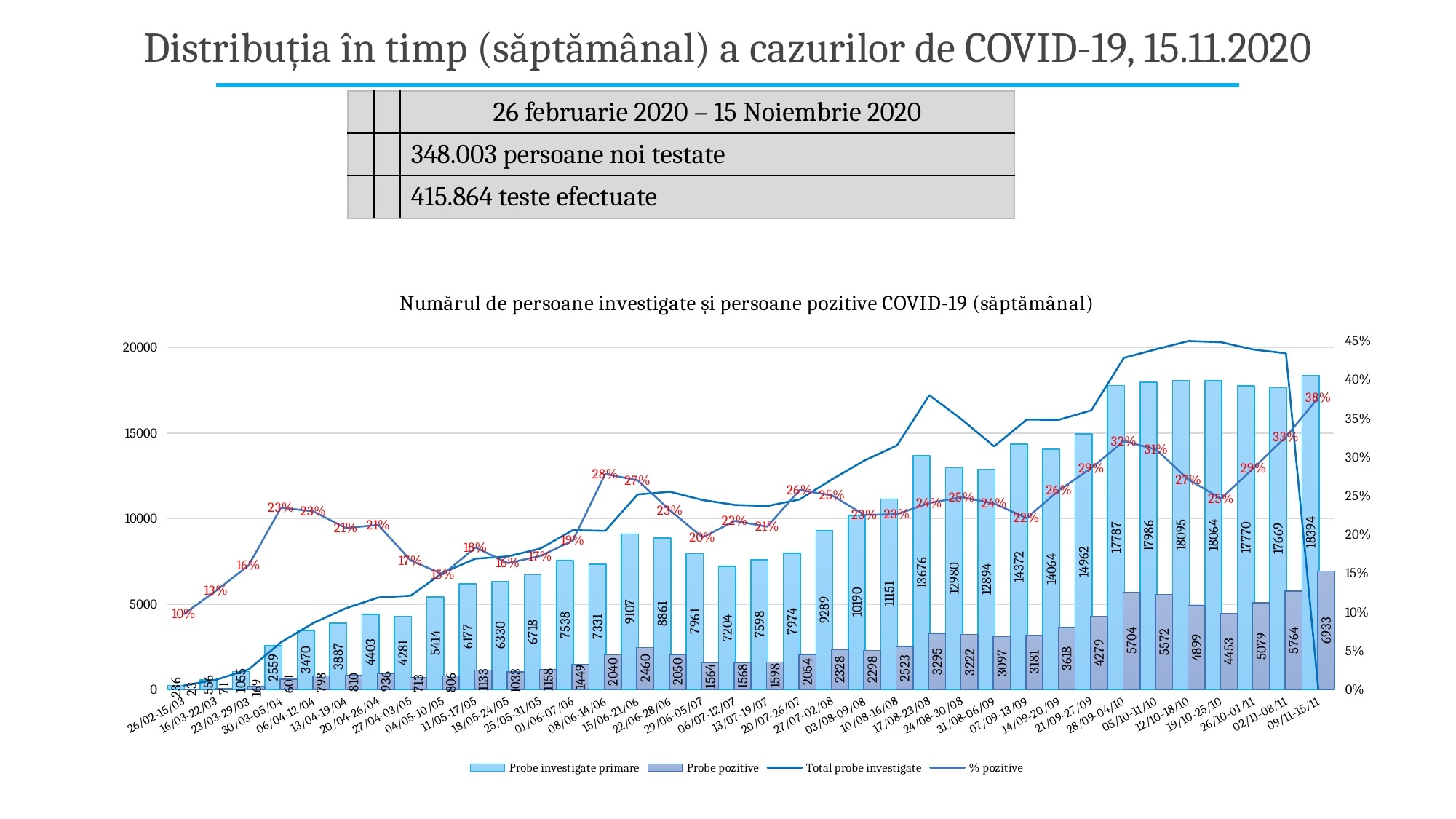
What is the title of the chart? Numărul de persoane investigate și persoane pozitive COVID-19 (săptămânal) What is the value of Probe pozitive for the week 09/11-15/11? 6933 What is the value of Probe investigate primare for the week 28/09-04/10? 17787 Which week has the larger value of Probe investigate primare: 17/08-23/08 or 24/08-30/08? 17/08-23/08 What is the % pozitive value for the week 09/11-15/11? 38% What kind of chart is shown on the slide? A combined bar and line chart How many weekly periods are shown on the x axis of the chart? 36 What is the difference between Probe pozitive for 09/11-15/11 and for 02/11-08/11? 1169 Which week has the highest value of Probe investigate primare? 09/11-15/11 What is the % pozitive value for the week 28/09-04/10? 32% Do the Probe investigate primare values generally rise or fall from left to right along the x axis? Rise How many series does the legend of the chart list? 4